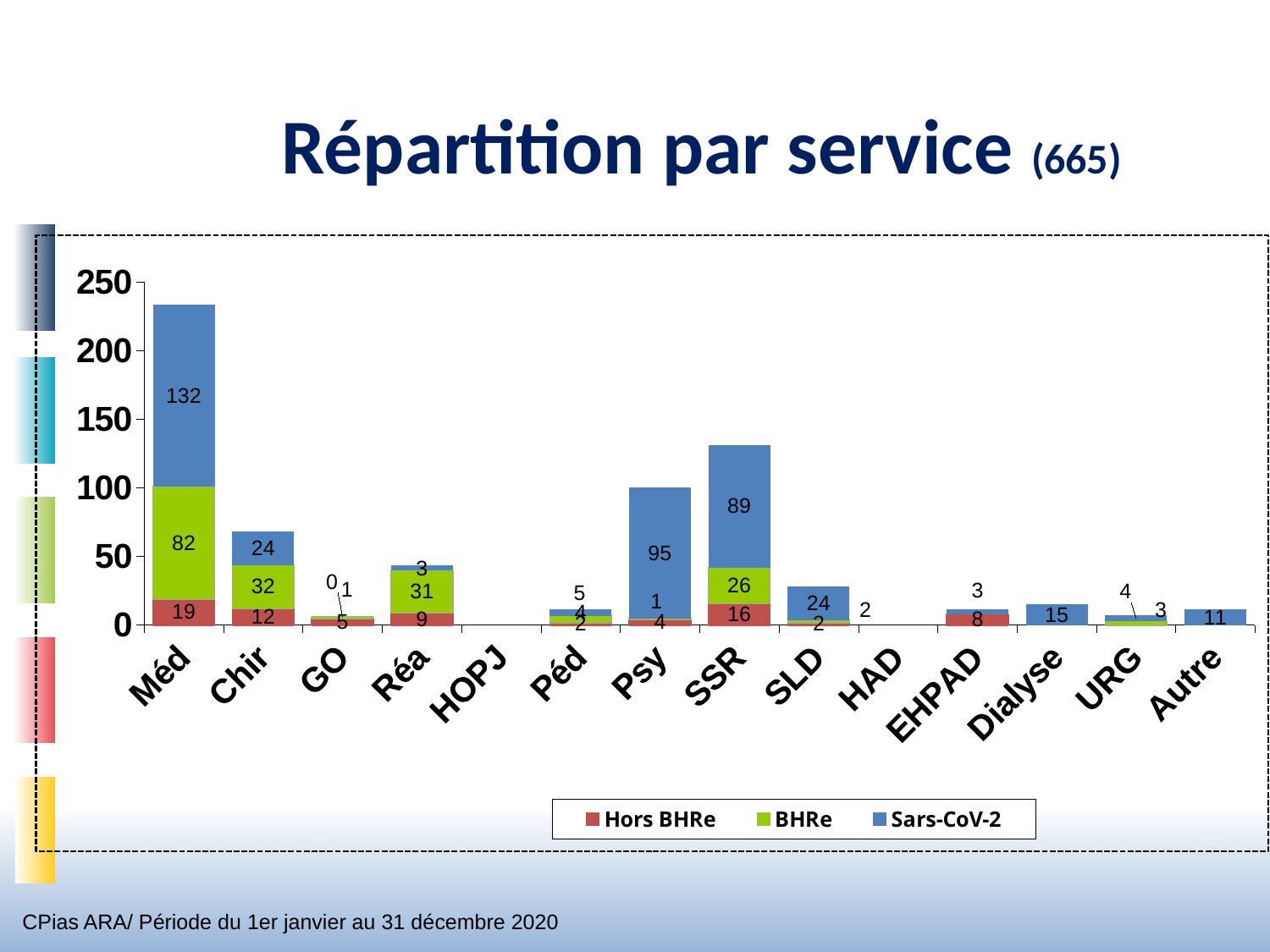
How many series does the legend list? 3 What is the total of the stacked bar for Méd? 233 What is the Sars-CoV-2 value for Psy? 95 What is the Sars-CoV-2 value for Méd? 132 What is the Sars-CoV-2 value for Dialyse? 15 What is the Hors BHRe value for SSR? 16 What is the difference between the Sars-CoV-2 values for Méd and Psy? 37 Is the total stacked bar for Méd greater or less than 200? greater Which service has the tallest stacked bar? Méd What is the BHRe value for Réa? 31 Which is larger, the Sars-CoV-2 value for Psy or for SSR? Psy What is the BHRe value for Méd? 82